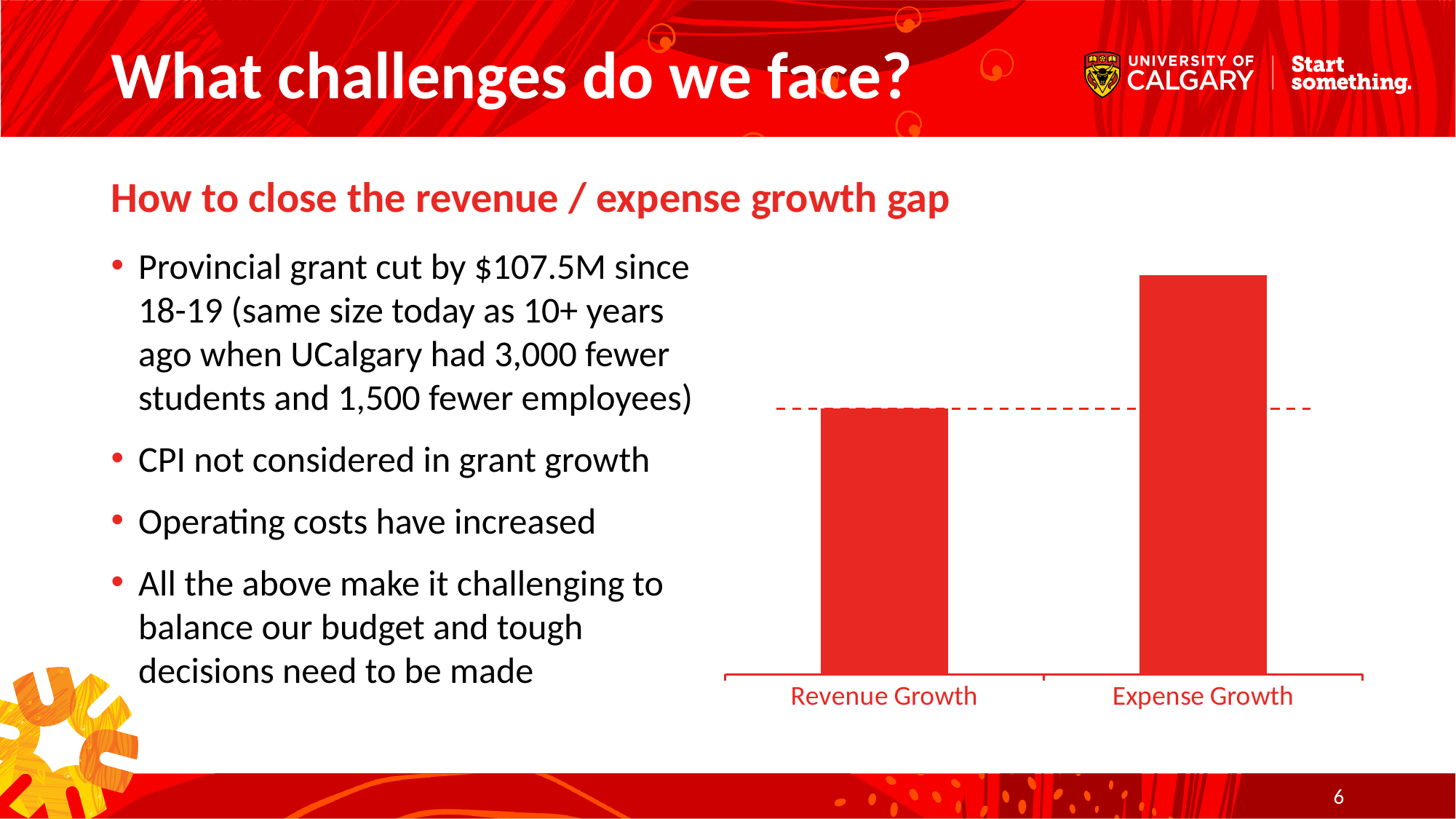
Which category has the highest bar in the chart? Expense Growth Which category has the lowest bar in the chart? Revenue Growth What colour are the bars in the chart? red Is the bar for Revenue Growth taller or shorter than the bar for Expense Growth? shorter Which is larger in the chart, Revenue Growth or Expense Growth? Expense Growth What are the two category labels on the x axis of the chart? Revenue Growth, Expense Growth How many categories does the bar chart show? 2 What kind of chart is shown on the slide? bar chart